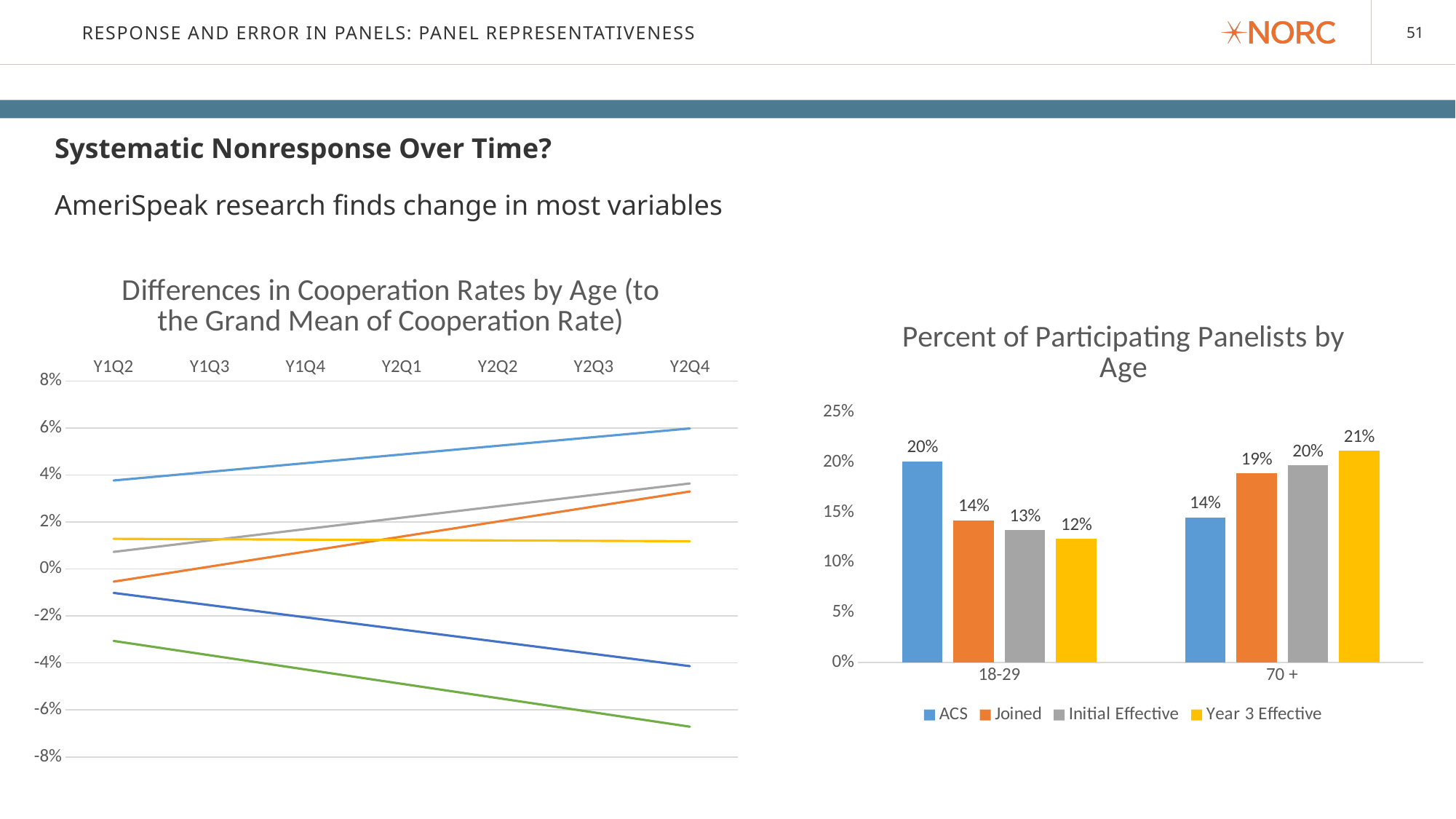
In the 'Percent of Participating Panelists by Age' chart, what is the Year 3 Effective value for the 70 + group? 21% In the 'Differences in Cooperation Rates by Age' chart on the left, how many time points are shown on the x axis? 7 In the 'Percent of Participating Panelists by Age' chart, what is the Initial Effective value for the 18-29 group? 13% In the 'Percent of Participating Panelists by Age' chart, what is the difference between the ACS value and the Year 3 Effective value for the 18-29 group? 8% In the 'Percent of Participating Panelists by Age' chart, which series has the highest value for the 70 + group? Year 3 Effective In the 'Percent of Participating Panelists by Age' chart, which is larger for the 70 + group: the Joined value or the ACS value? Joined What kind of chart is the 'Differences in Cooperation Rates by Age' chart on the left? Line chart In the 'Percent of Participating Panelists by Age' chart, which series has the lowest value for the 18-29 group? Year 3 Effective In the 'Percent of Participating Panelists by Age' chart, how many age groups are shown on the x axis? 2 What kind of chart is the 'Percent of Participating Panelists by Age' chart? Bar chart In the 'Percent of Participating Panelists by Age' chart, what is the ACS value for the 18-29 group? 20% In the 'Percent of Participating Panelists by Age' chart, how many series does the legend list? 4